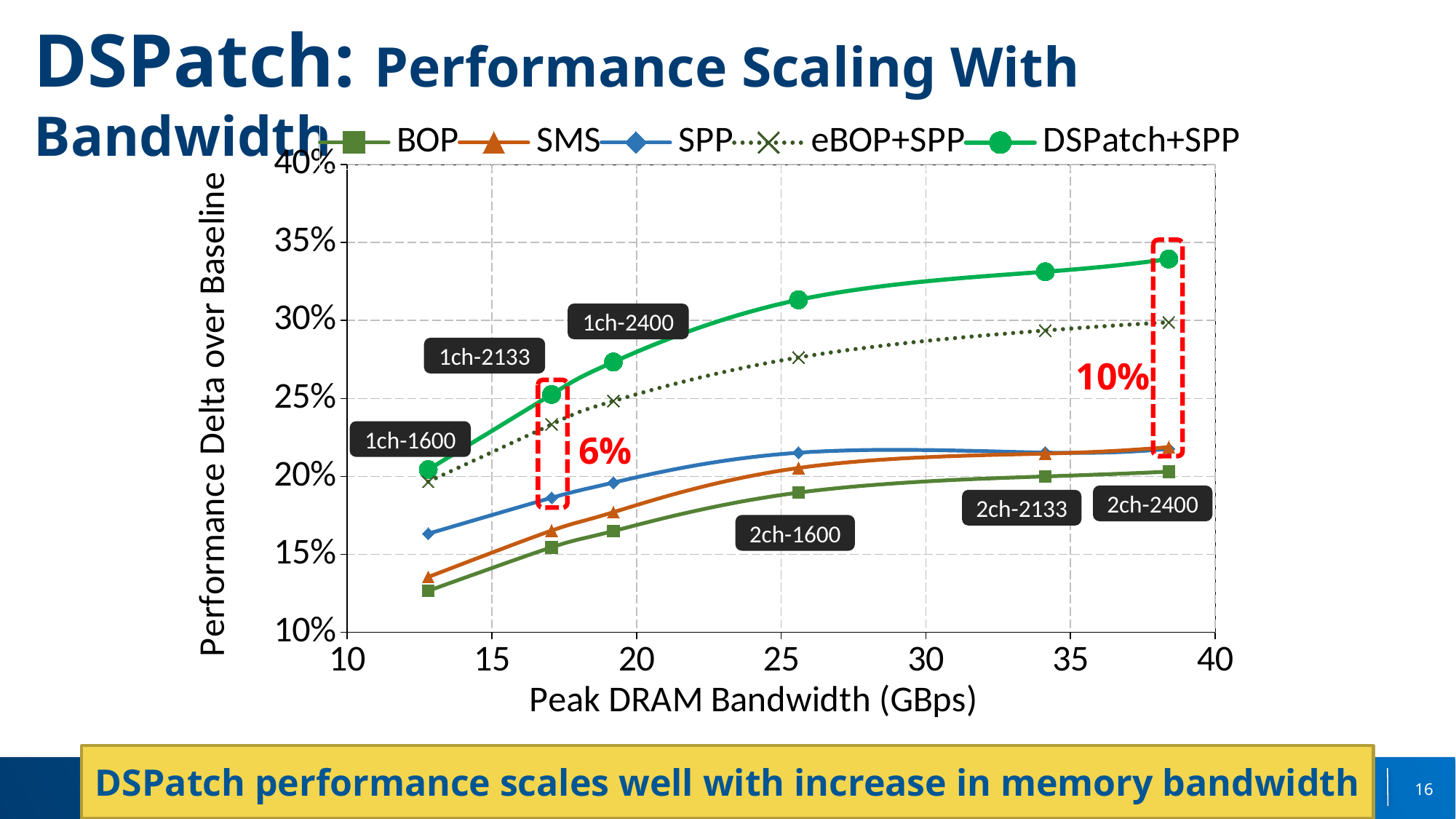
What is the title of the x axis? Peak DRAM Bandwidth (GBps) Which series has the highest performance delta at the 2ch-2400 configuration? DSPatch+SPP How many series does the legend list? 5 At 2ch-2400, which series has the larger performance delta, DSPatch+SPP or eBOP+SPP? DSPatch+SPP What kind of chart is shown on the slide? line chart What percentage gap is annotated in red at the 2ch-2400 configuration? 10% Is the value for BOP at 1ch-1600 greater or less than 15%? less Is the value for DSPatch+SPP at 2ch-2400 greater or less than 30%? greater Which series has the lowest performance delta at the 1ch-1600 configuration? BOP Does the performance delta for DSPatch+SPP rise or fall as peak DRAM bandwidth increases? rise How many data points are plotted for the DSPatch+SPP series? 6 Is the value for eBOP+SPP at 2ch-1600 greater or less than 25%? greater